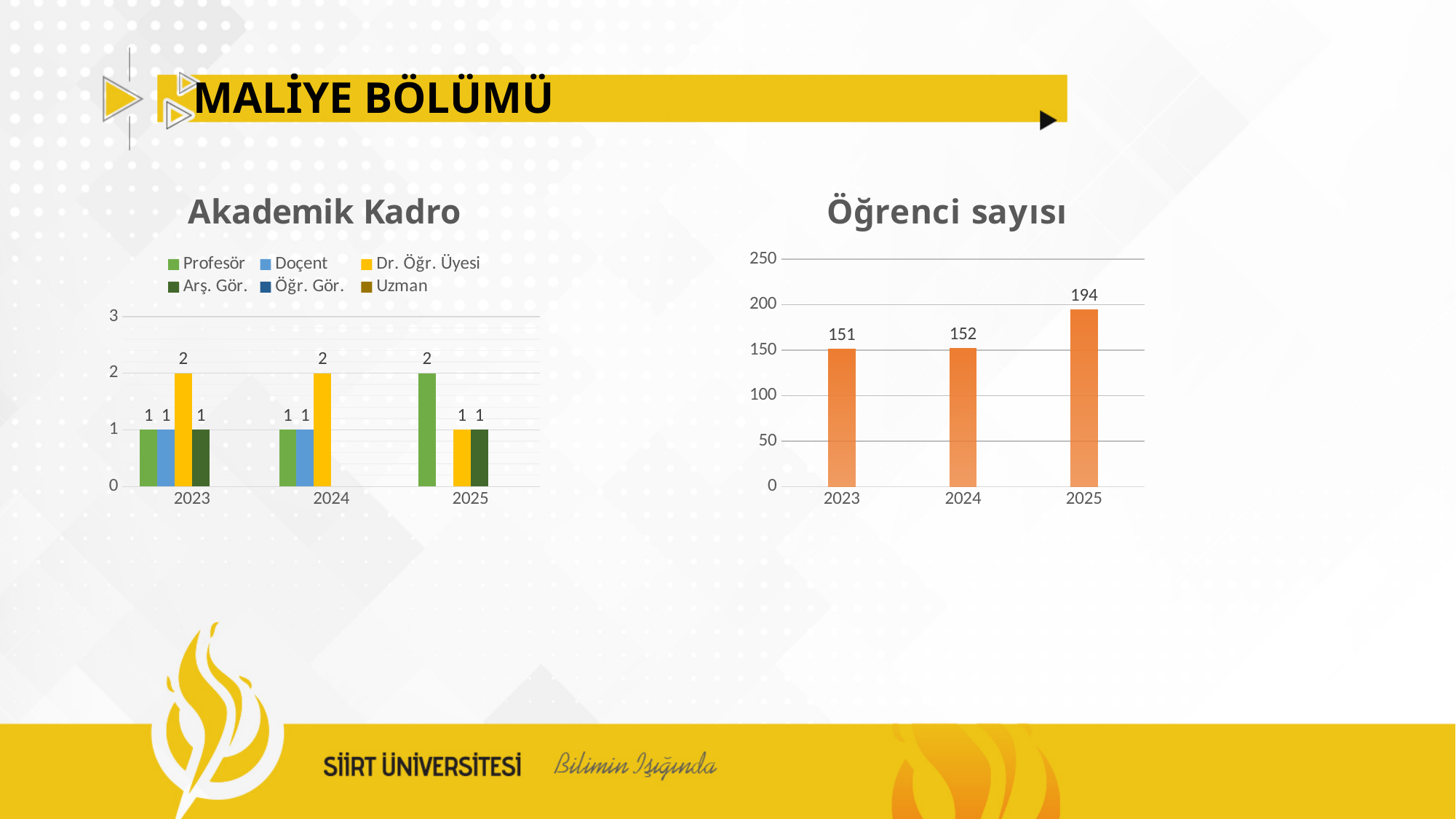
What kind of chart is the Öğrenci sayısı chart? bar chart In the Öğrenci sayısı chart, which year has the highest value? 2025 In the Öğrenci sayısı chart, what is the difference between the values for 2025 and 2024? 42 In the Akademik Kadro chart, how many series does the legend list? 6 In the Öğrenci sayısı chart, do the values rise or fall from 2023 to 2025? rise In the Akademik Kadro chart, which colour represents Dr. Öğr. Üyesi? yellow In the Akademik Kadro chart, which is larger in 2024: Profesör or Dr. Öğr. Üyesi? Dr. Öğr. Üyesi In the Öğrenci sayısı chart, what is the value for 2025? 194 In the Öğrenci sayısı chart, what is the value for 2023? 151 In the Akademik Kadro chart, what is the value for Profesör in 2025? 2 In the Öğrenci sayısı chart, how many years are shown on the x axis? 3 In the Akademik Kadro chart, what is the value for Dr. Öğr. Üyesi in 2023? 2